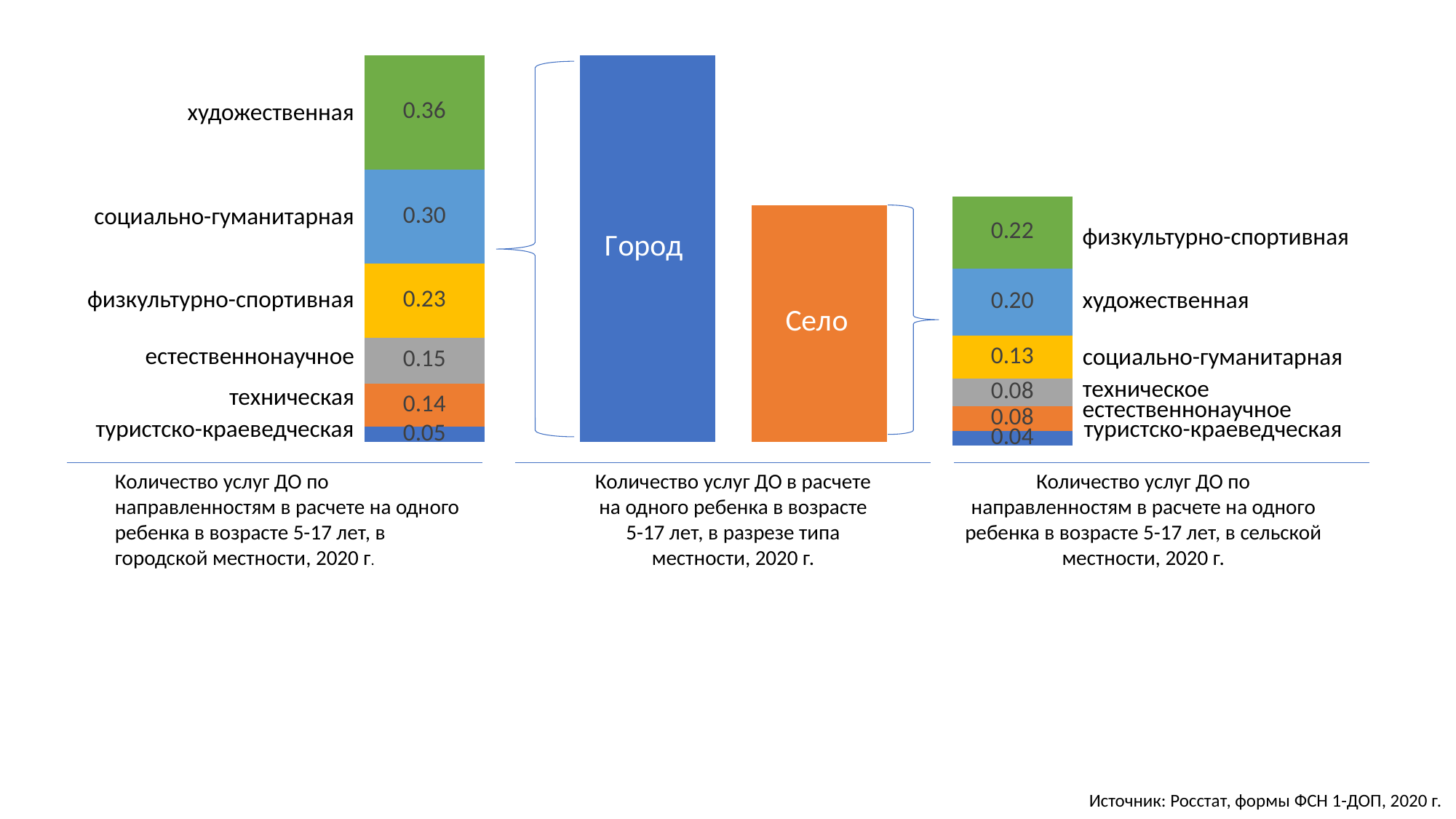
In the left chart (urban area), what is the difference between художественная and физкультурно-спортивная? 0.13 In the left chart (urban area), which category has the highest value? художественная In the left chart (urban area), what is the value for художественная? 0.36 In the right chart (rural area), which category has the lowest value? туристско-краеведческая In the left chart (urban area), what is the value for естественнонаучное? 0.15 How many categories are stacked in the left chart (urban area)? 6 In the middle chart, which bar is taller: Город or Село? Город In the right chart (rural area), what is the value for социально-гуманитарная? 0.13 Which is larger: художественная in the left chart (urban) or художественная in the right chart (rural)? художественная in the left chart (urban), 0.36 What type of chart is the middle chart? bar chart In the right chart (rural area), what is the value for туристско-краеведческая? 0.04 What is the total of the stacked bar in the right chart (rural area)? 0.75